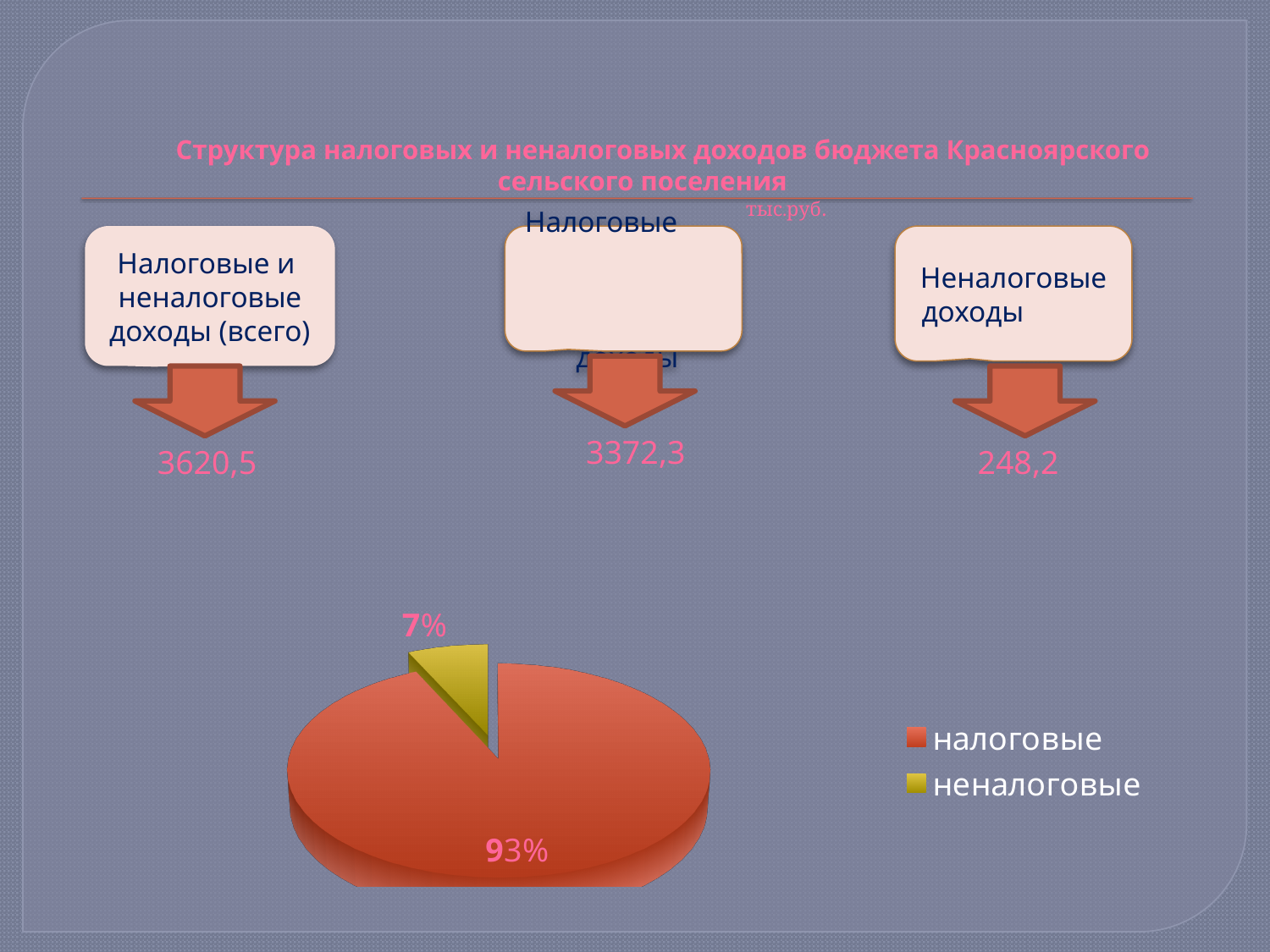
Which slice of the pie chart is the smallest? неналоговые What colour is the налоговые slice in the pie chart? red Which is larger in the pie chart, налоговые or неналоговые? налоговые What is the difference in percentage points between the налоговые and неналоговые slices of the pie chart? 86 What share of the pie chart does the неналоговые slice represent? 7% How many slices does the pie chart have? 2 What kind of chart is shown at the bottom of the slide? pie chart How many entries does the pie chart's legend list? 2 What share of the pie chart does the налоговые slice represent? 93% What colour is the неналоговые slice in the pie chart? yellow According to the slide, what is the value of Налоговые доходы in тыс.руб.? 3372,3 Which slice of the pie chart is the largest? налоговые